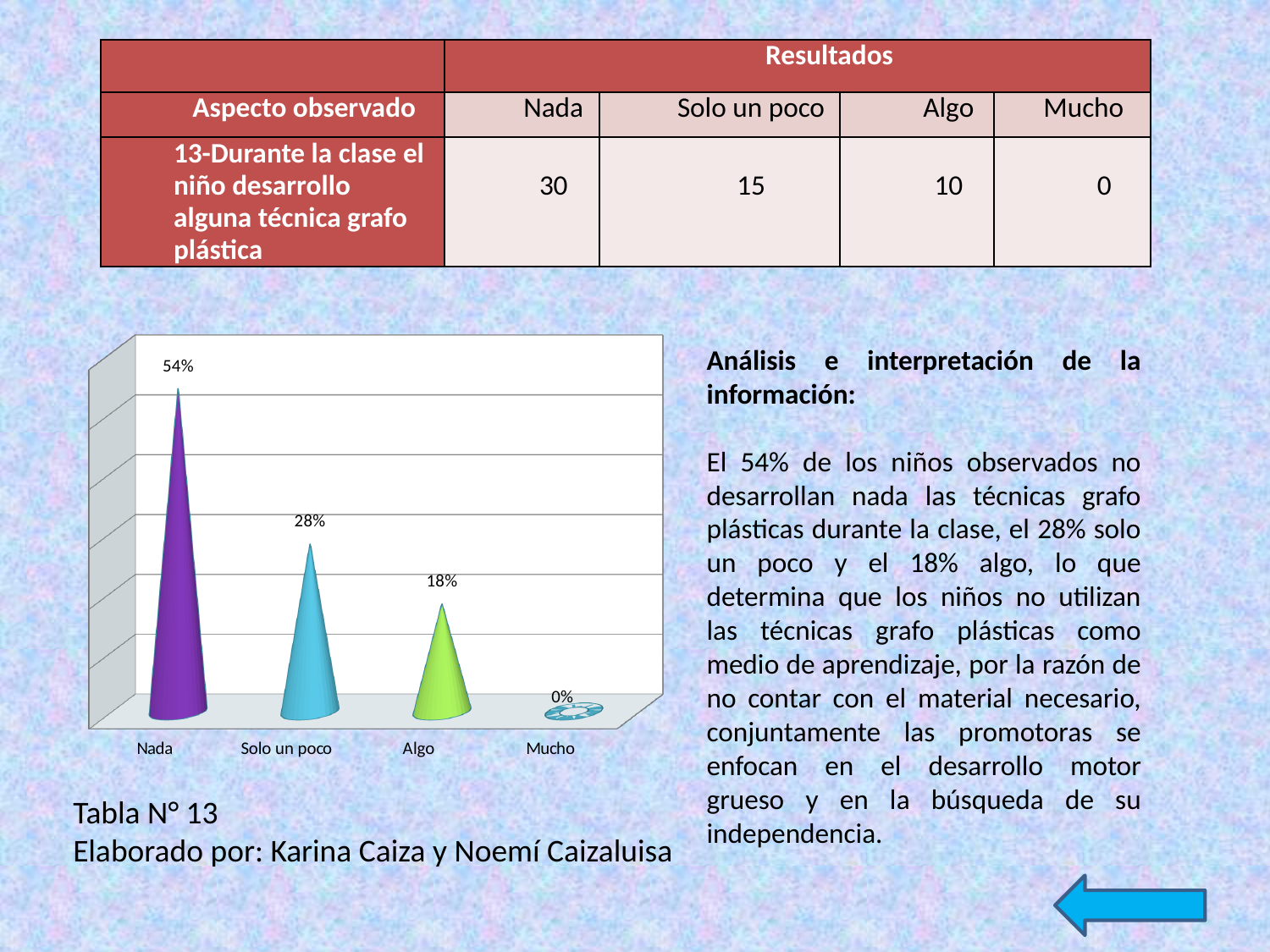
What is the value shown for Nada in the chart? 54% How many categories are shown on the x axis of the chart? 4 What is the difference between the values for Solo un poco and Algo? 10% What kind of chart is shown on the slide? Bar chart What is the value shown for Algo in the chart? 18% Do the values rise or fall from left to right along the x axis? Fall What is the difference between the values for Nada and Solo un poco? 26% Which category has the lowest value in the chart? Mucho Which category has the highest value in the chart? Nada What is the value shown for Mucho in the chart? 0% Which is larger, the value for Algo or the value for Solo un poco? Solo un poco What is the value shown for Solo un poco in the chart? 28%